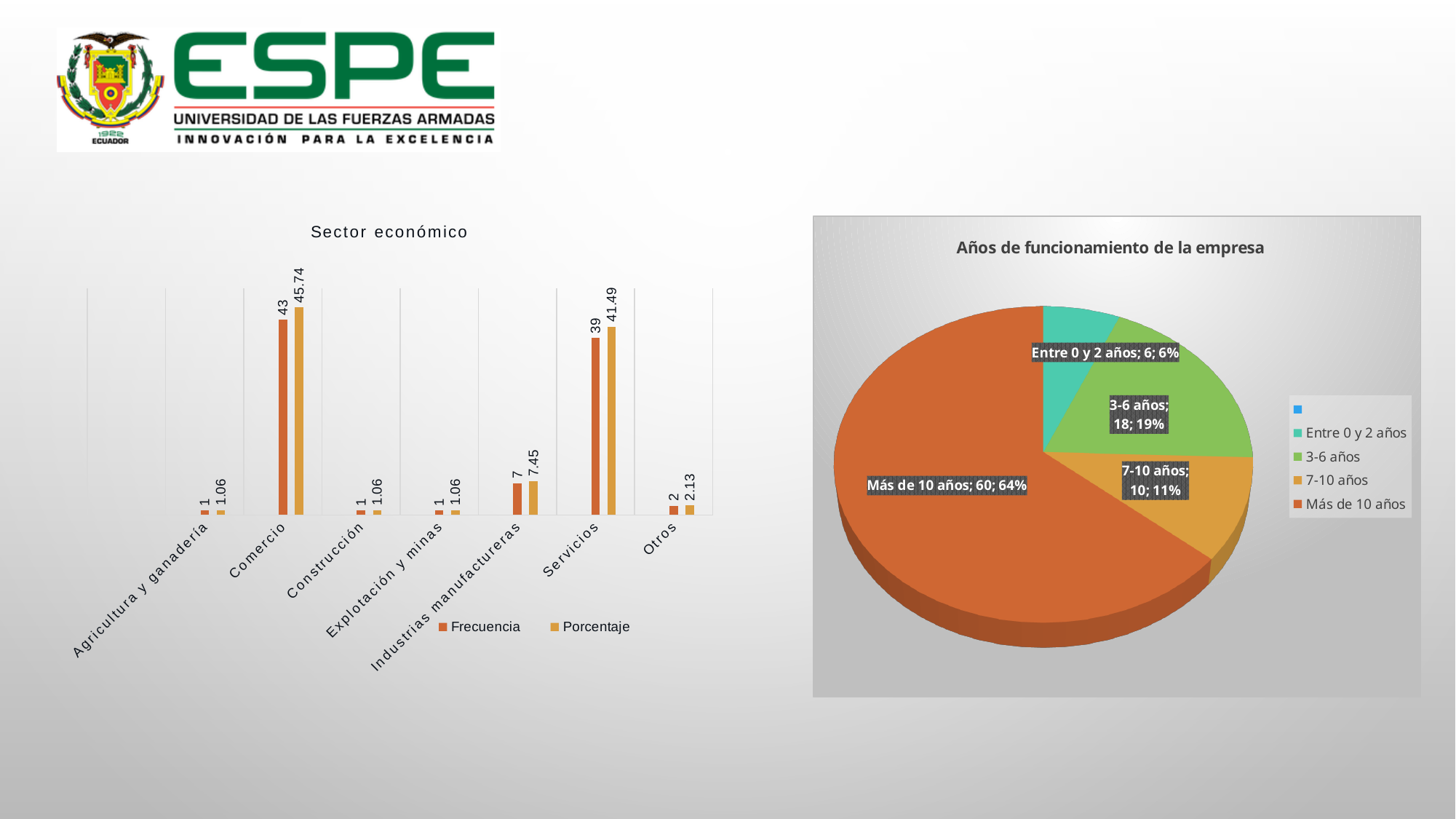
In the 'Sector económico' chart, what is the Porcentaje value for Servicios? 41.49 In the 'Sector económico' chart, what is the Porcentaje value for Industrias manufactureras? 7.45 How many categories are shown on the x axis of the 'Sector económico' chart? 7 In the 'Sector económico' chart, what is the Frecuencia value for Comercio? 43 In the 'Sector económico' chart, which has a larger Frecuencia, Industrias manufactureras or Otros? Industrias manufactureras What kind of chart is 'Años de funcionamiento de la empresa'? Pie chart In the 'Años de funcionamiento de la empresa' pie chart, what is the value for '3-6 años'? 18 How many series does the legend of the 'Sector económico' chart list? 2 In the 'Años de funcionamiento de la empresa' pie chart, what share does 'Más de 10 años' have? 64% In the 'Sector económico' chart, what is the difference in Frecuencia between Comercio and Servicios? 4 In the 'Años de funcionamiento de la empresa' pie chart, which slice is the smallest? Entre 0 y 2 años In the 'Sector económico' chart, which category has the highest Frecuencia? Comercio